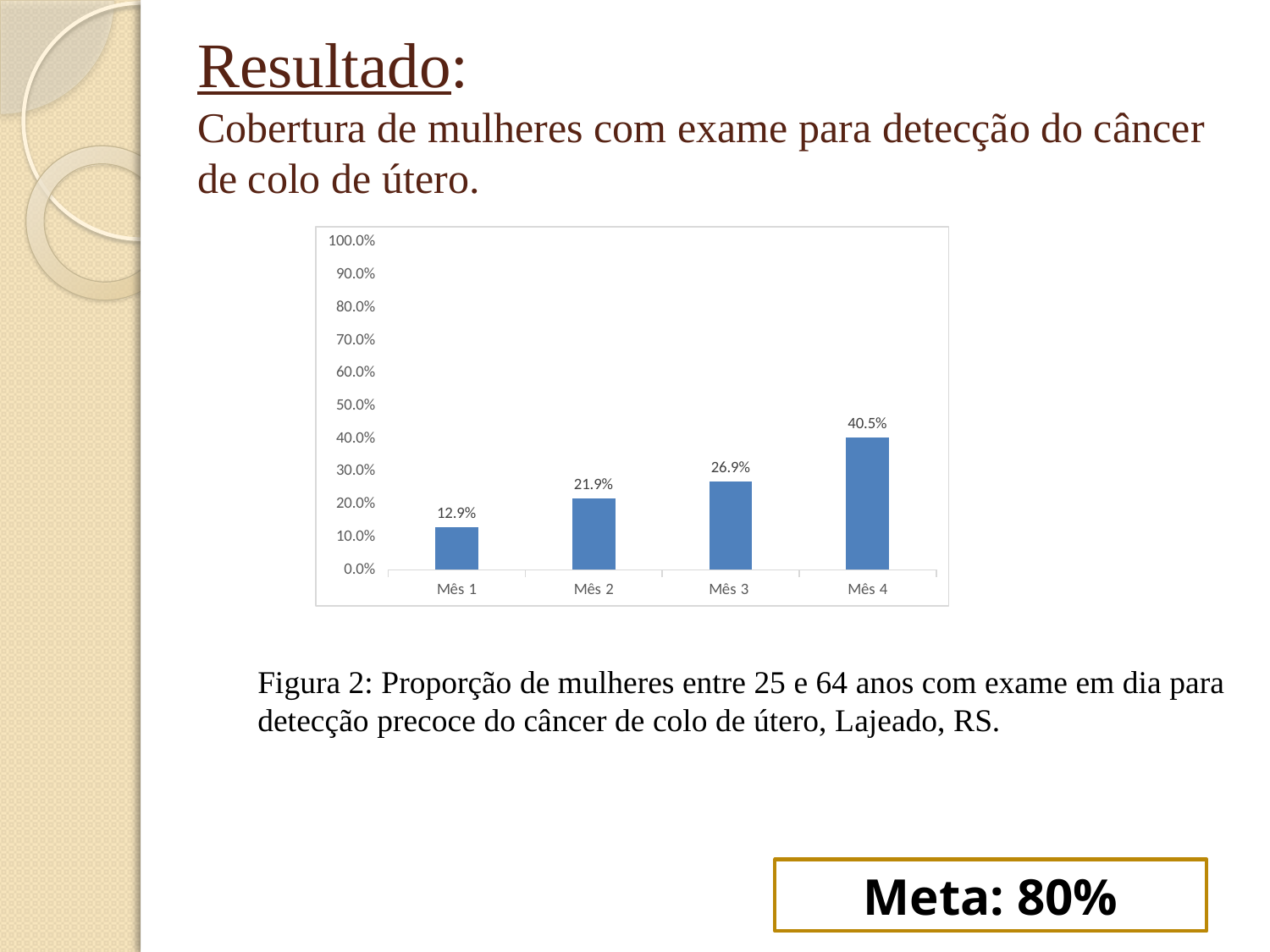
What kind of chart is shown on the slide? bar chart Which month has the highest value? Mês 4 How many months are shown on the x axis? 4 Which is larger, the value for Mês 2 or the value for Mês 3? Mês 3 What is the difference between the values for Mês 2 and Mês 1? 9.0% What is the value for Mês 3? 26.9% Do the values rise or fall from Mês 1 to Mês 4? rise What is the value for Mês 1? 12.9% What is the difference between the values for Mês 4 and Mês 1? 27.6% Which month has the lowest value? Mês 1 What is the value for Mês 4? 40.5% Is the value for Mês 4 greater or less than 50.0%? less